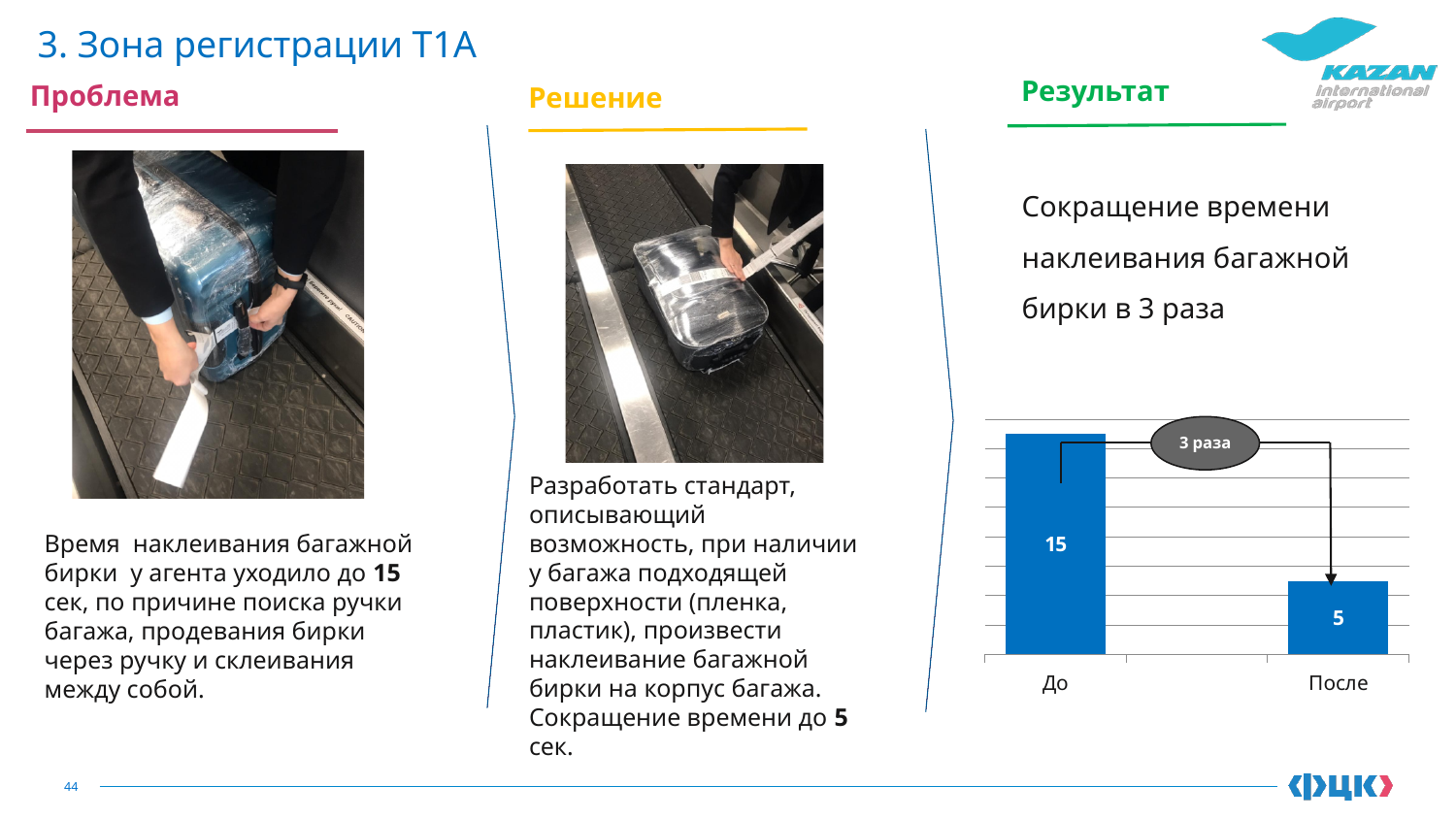
What text is written in the grey oval above the bars in the chart? 3 раза How many categories are shown in the chart? 2 What colour are the bars in the chart? blue What is the value for "После" in the chart? 5 What is the value for "До" in the chart? 15 What kind of chart is shown on the slide? bar chart Do the values rise or fall from "До" to "После"? fall Which is larger, the value for "До" or the value for "После"? До Which category has the lowest value in the chart? После What is the difference between the values for "До" and "После"? 10 Which category has the highest value in the chart? До